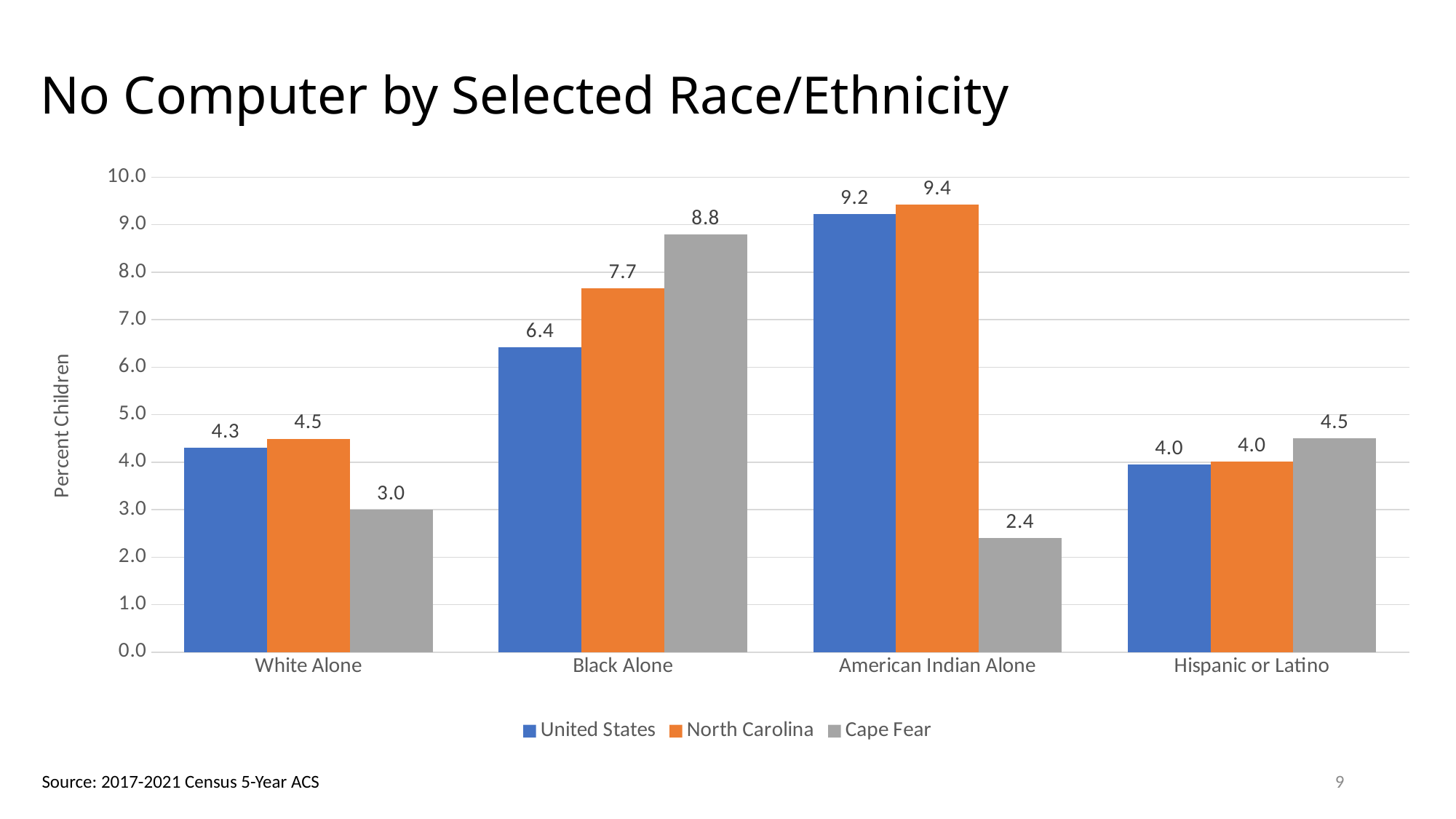
What is the United States value for White Alone? 4.3 What is the North Carolina value for American Indian Alone? 9.4 How many race/ethnicity categories are shown on the x axis? 4 How many series does the legend list? 3 Which is larger for Hispanic or Latino: the Cape Fear value or the United States value? Cape Fear Which category has the highest United States value? American Indian Alone What is the label on the vertical axis? Percent Children What kind of chart is shown on the slide? bar chart Is the Cape Fear value for White Alone greater or less than 4.0? less What is the Cape Fear value for Black Alone? 8.8 Which category has the lowest Cape Fear value? American Indian Alone What is the difference between the North Carolina and United States values for Black Alone? 1.3